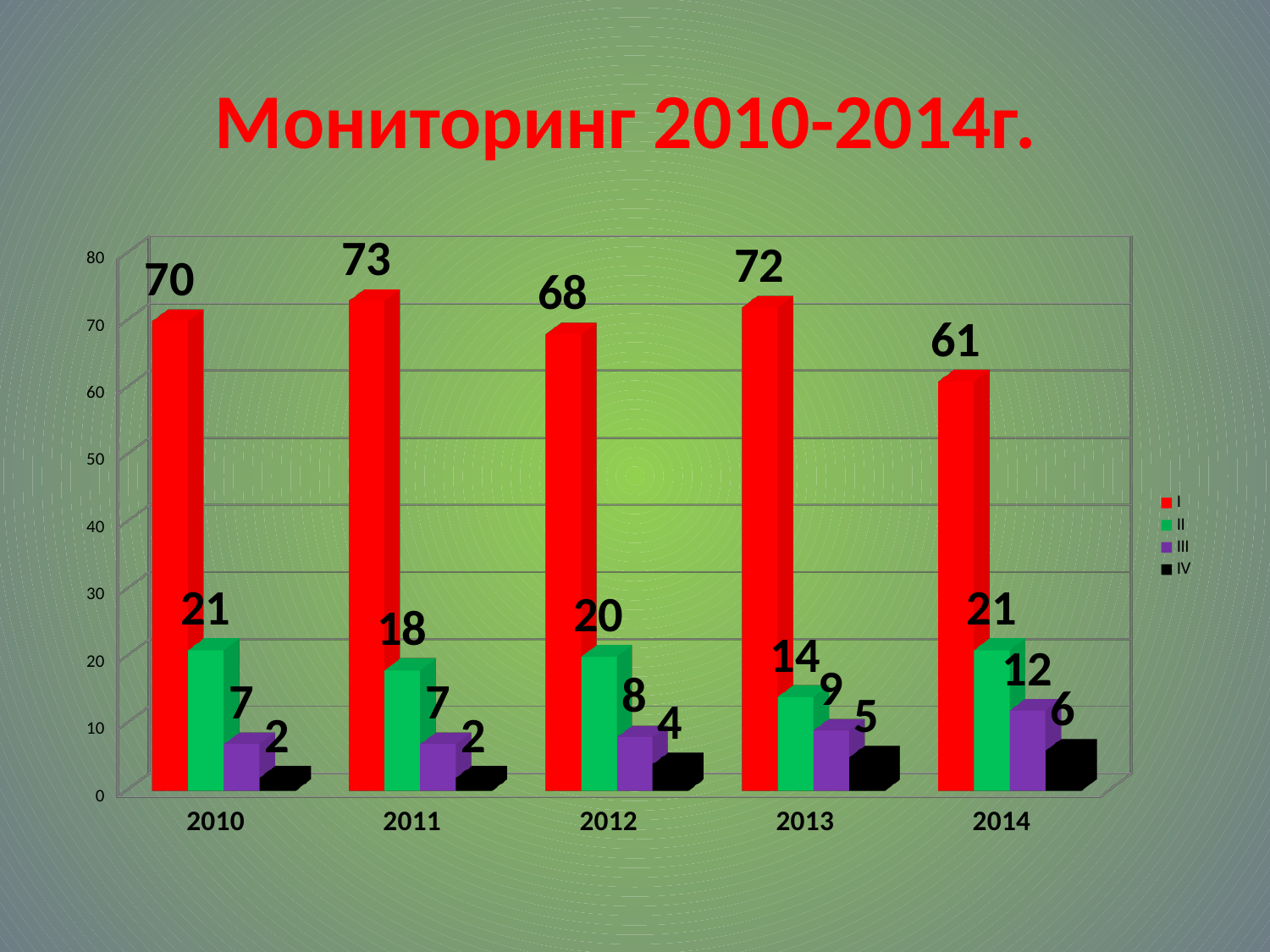
What is the title of the slide? Мониторинг 2010-2014г. Which is larger: series II in 2012 or series II in 2013? Series II in 2012 What is the value of series I for 2011? 73 In which year is series I lowest? 2014 What is the value of series II for 2013? 14 What is the value of series III for 2014? 12 What kind of chart is shown on the slide? Bar chart In which year is series I highest? 2011 How many years are shown on the x axis? 5 What is the value of series IV for 2012? 4 What is the difference between series I in 2011 and series I in 2014? 12 How many series does the legend list? 4